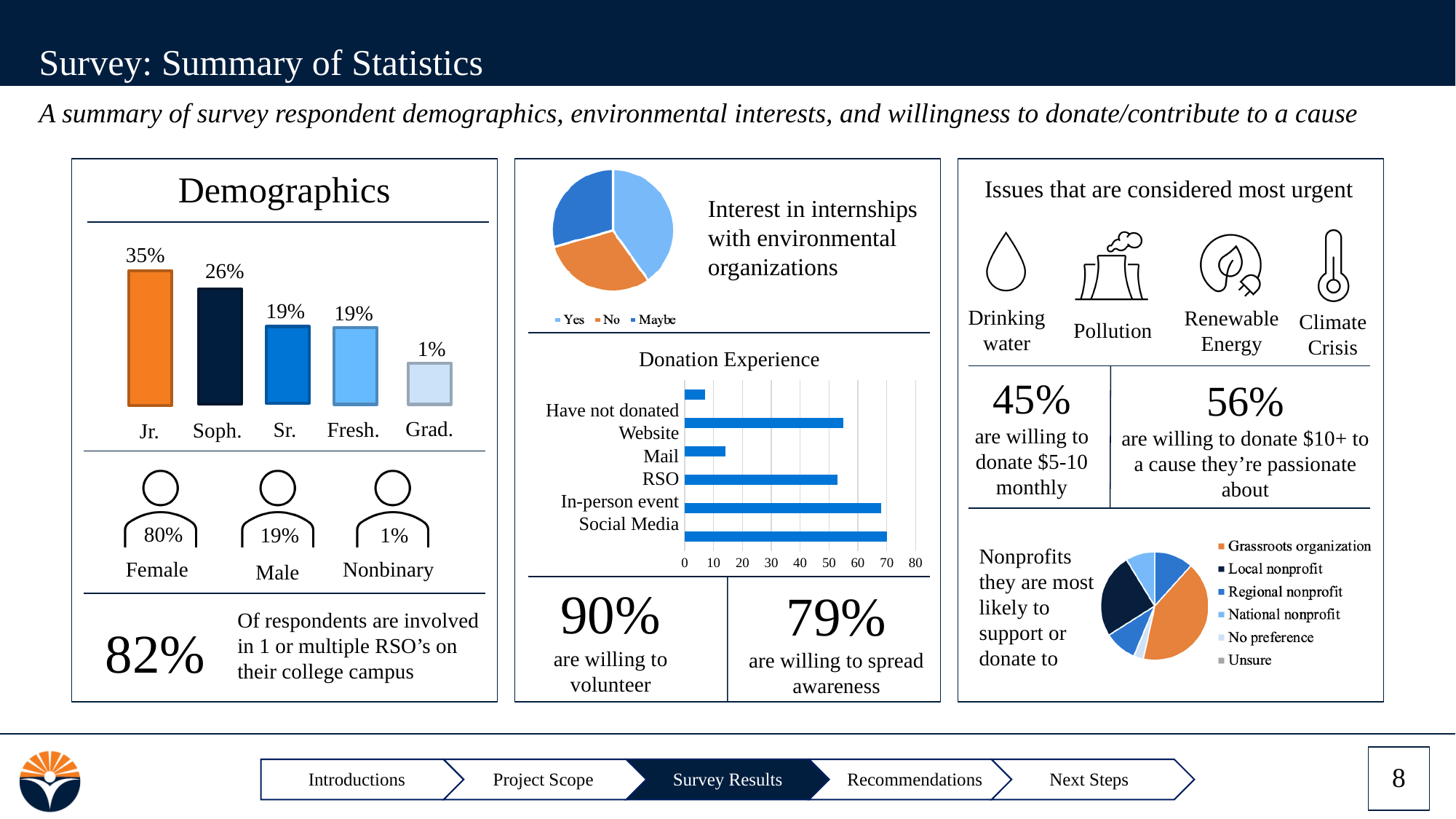
In the Demographics bar chart, which class year has the lowest percentage of respondents? Grad. In the Donation Experience chart, is the value for 'In-person event' greater or less than 60? greater In the Demographics bar chart, which class year has the highest percentage of respondents? Jr. In the Demographics bar chart, what percentage of respondents are Juniors (Jr.)? 35% In the 'Nonprofits they are most likely to support or donate to' pie chart, which category has the largest slice? Grassroots organization In the Demographics bar chart, which is larger, the value for Soph. or the value for Sr.? Soph. How many class-year categories are shown in the Demographics bar chart? 5 What kind of chart is the Donation Experience chart? Bar chart In the 'Interest in internships with environmental organizations' pie chart, which response has the largest slice? Yes How many entries does the legend of the 'Interest in internships with environmental organizations' pie chart list? 3 In the Demographics bar chart, what is the difference between the Jr. and Soph. percentages? 9% In the Donation Experience chart, is the value for 'Have not donated' greater or less than 10? less